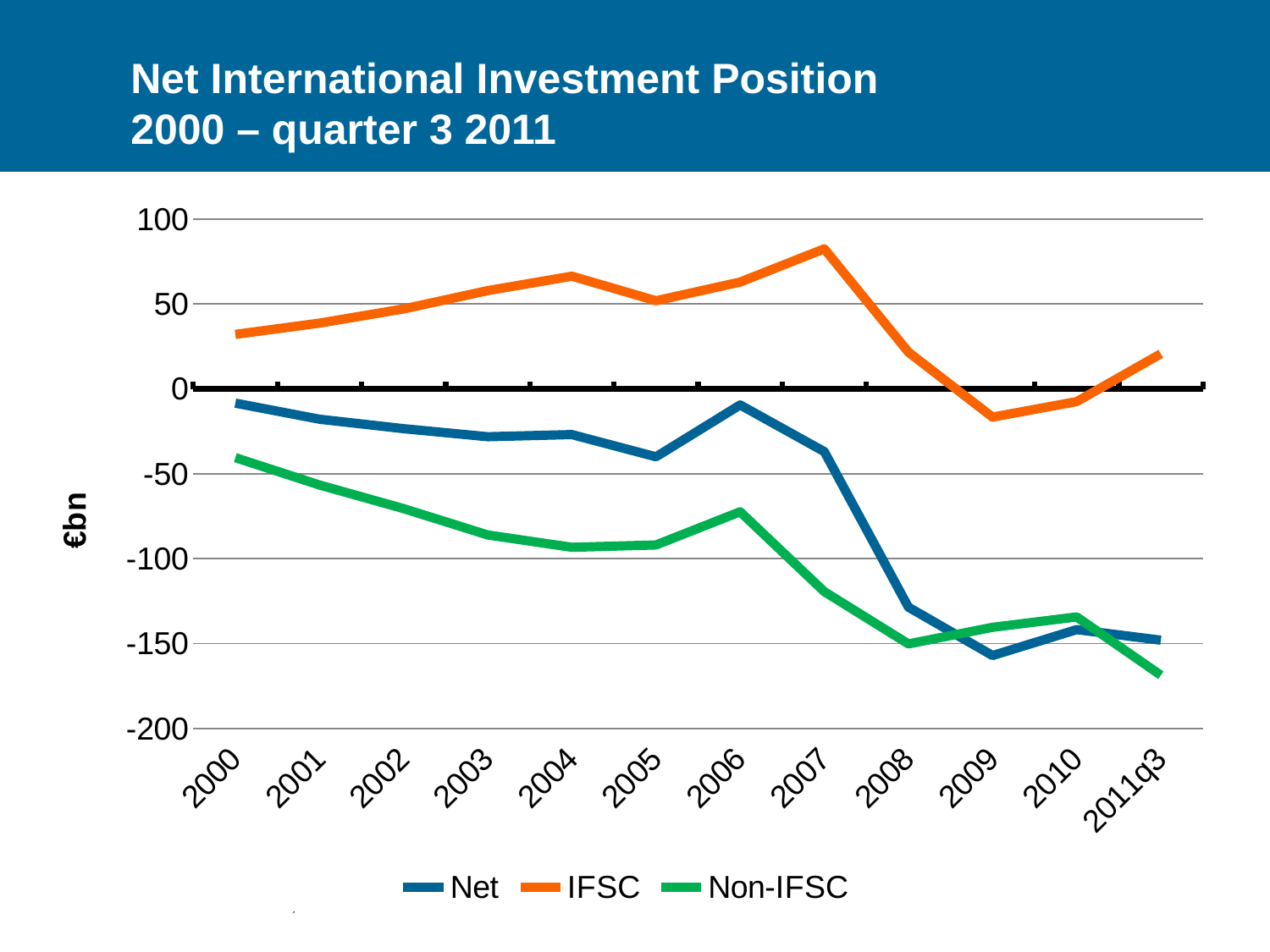
In which year does the IFSC series reach its highest value? 2007 In which period does the Non-IFSC series reach its lowest value? 2011q3 Is the IFSC value for 2009 greater or less than 0? less Does the Non-IFSC series rise or fall between 2000 and 2004? fall What kind of chart is shown on the slide? Line chart Is the Non-IFSC value for 2011q3 greater or less than -150? less Is the Non-IFSC value for 2000 greater or less than -50? greater In 2008, which series has the higher value: Net or Non-IFSC? Net How many series does the legend list? 3 How many time points are plotted along the x axis? 12 What unit is shown on the y axis label? €bn